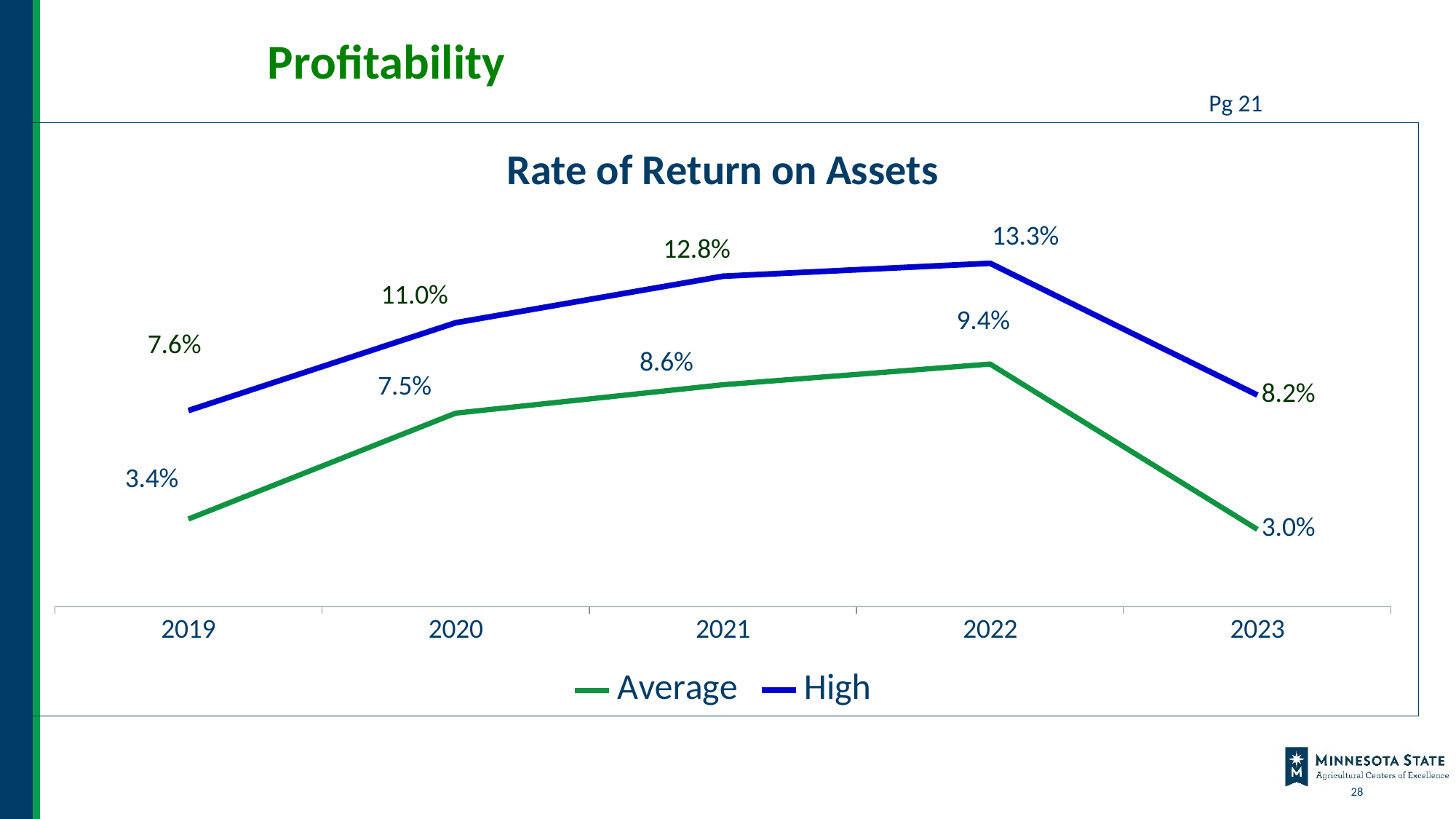
What is the difference between the High values in 2019 and 2023? 0.6% In which year is the High series at its highest? 2022 What kind of chart is shown? line chart How many series does the legend list? 2 What is the Average rate of return on assets in 2021? 8.6% What is the High rate of return on assets in 2020? 11.0% What is the Average value in 2023? 3.0% How many years are shown on the x axis? 5 Which is larger, the Average value in 2020 or the Average value in 2019? 2020 In which year is the Average series at its lowest? 2023 Does the Average series rise or fall from 2022 to 2023? fall What is the difference between the High and Average values in 2022? 3.9%